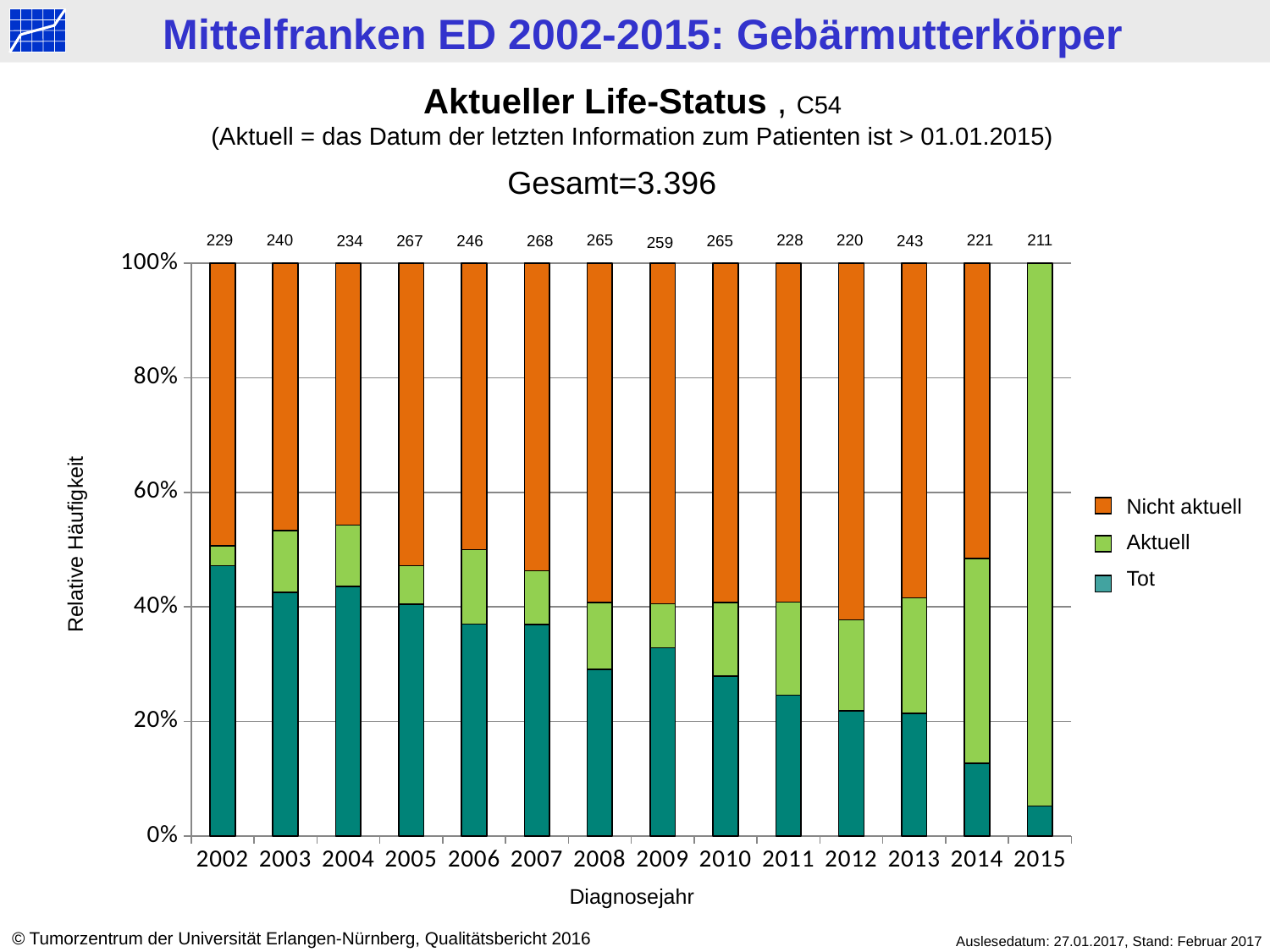
Which diagnosis year has the lowest number printed above its bar? 2015 What number is printed above the bar for 2002? 229 What number is printed above the bar for 2007? 268 How many diagnosis years are shown on the x axis? 14 What is the difference between the numbers printed above the bars for 2007 and 2002? 39 What kind of chart is shown on the slide? Stacked bar chart Is the share of 'Tot' in 2002 greater or less than 40%? greater What number is printed above the bar for 2015? 211 Which year has the larger number printed above its bar, 2005 or 2006? 2005 How many series does the legend list? 3 Which diagnosis year has the highest number printed above its bar? 2007 Is the share of 'Tot' in 2015 greater or less than 20%? less